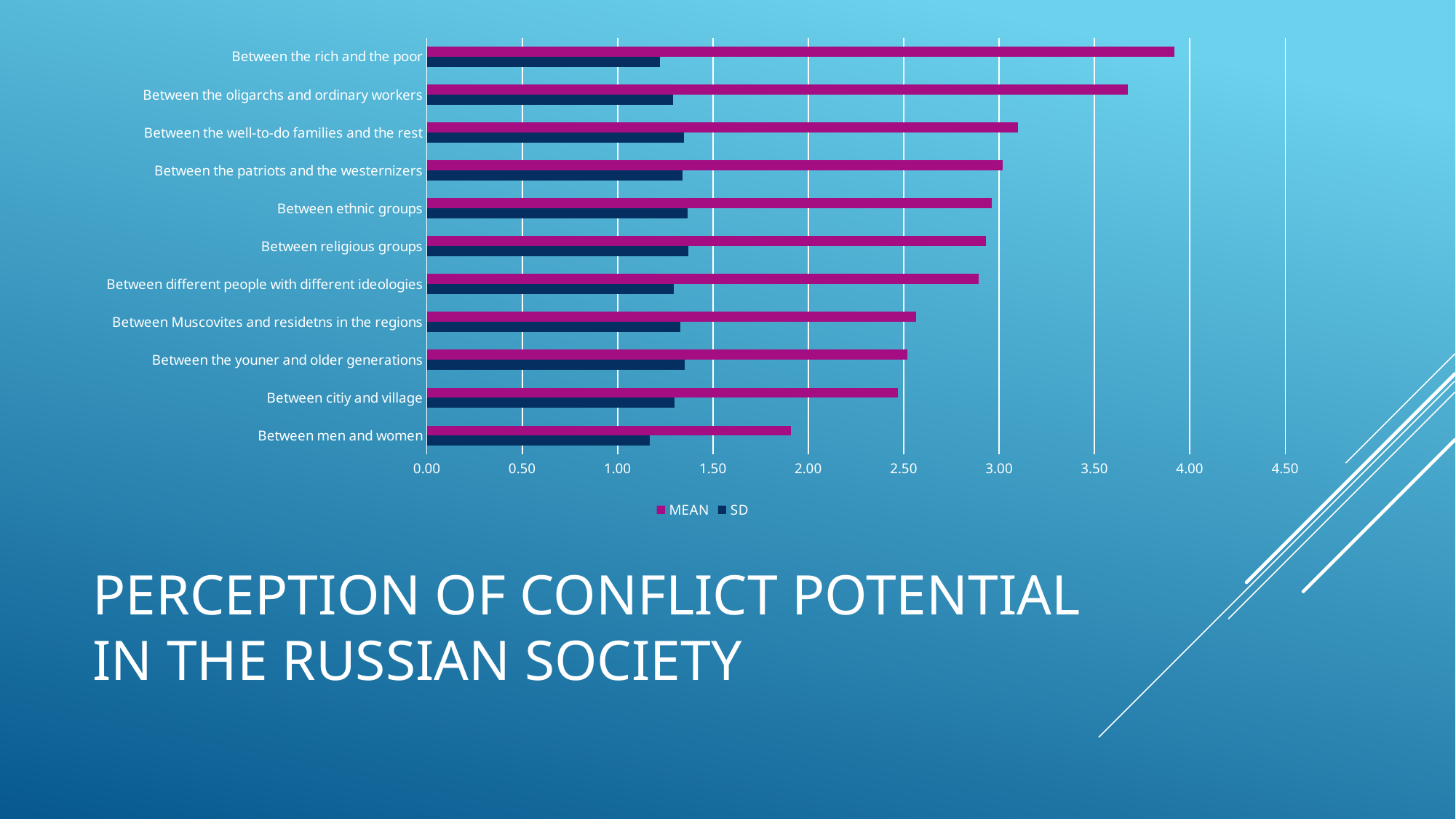
How many series does the legend list? 2 Is the MEAN value for 'Between the rich and the poor' greater or less than 3.50? greater Which category has the lowest MEAN value? Between men and women How many categories are plotted on the chart? 11 Is the MEAN value for 'Between men and women' greater or less than 2.00? less Is the SD value for 'Between the rich and the poor' greater or less than 1.50? less Which category has the highest MEAN value? Between the rich and the poor Which has a larger MEAN value: 'Between men and women' or 'Between citiy and village'? Between citiy and village What are the two series named in the legend? MEAN and SD What kind of chart is shown on the slide? bar chart Which has a larger MEAN value: 'Between the rich and the poor' or 'Between the oligarchs and ordinary workers'? Between the rich and the poor